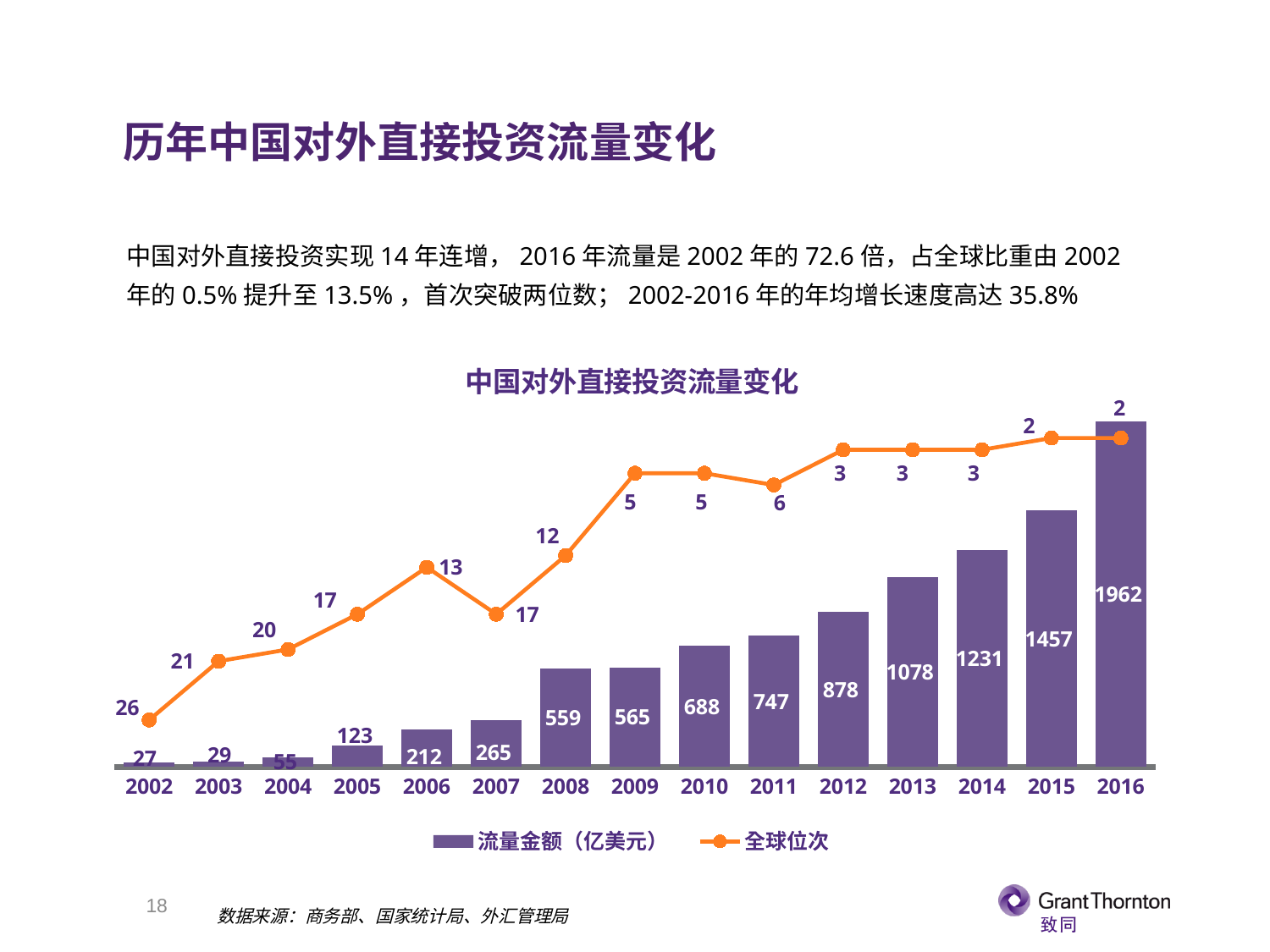
What is the 流量金额（亿美元） value for 2008? 559 What is the 全球位次 value for 2011? 6 What is the difference in 流量金额（亿美元） between 2016 and 2015? 505 What is the 流量金额（亿美元） value for 2016? 1962 Which year has the highest 流量金额（亿美元）? 2016 How many series does the legend list? 2 What is the 全球位次 value for 2002? 26 Do the 流量金额（亿美元） values generally rise or fall from 2002 to 2016? Rise Which is larger, the 流量金额（亿美元） for 2013 or for 2012? 2013 What kind of chart is this? Combined bar and line chart How many years are shown on the x axis? 15 Which year has the lowest 流量金额（亿美元）? 2002